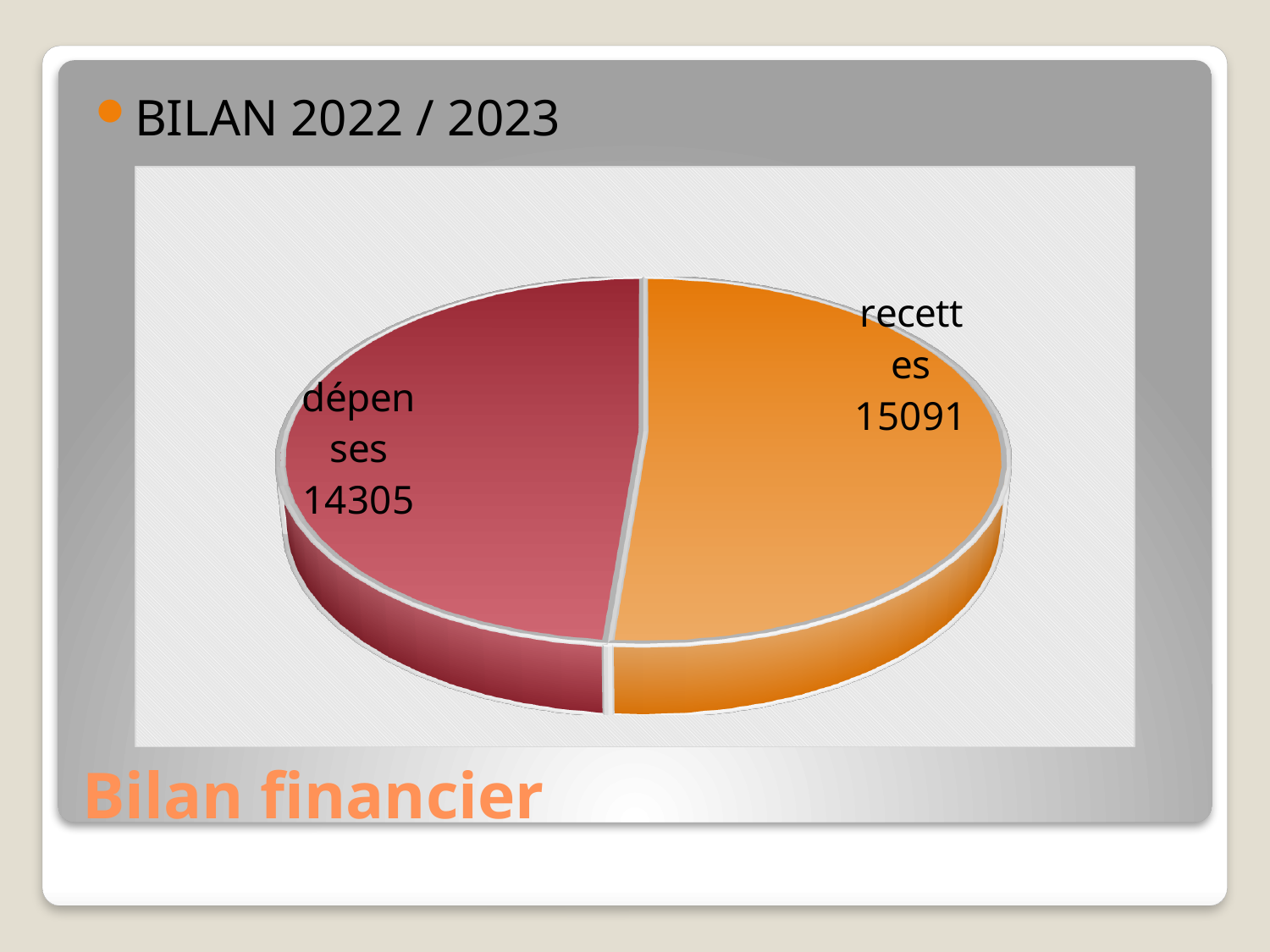
What colour is the recettes slice of the pie chart? orange How many slices does the pie chart have? 2 What is the difference between recettes and dépenses? 786 What share of the pie, to one decimal place, does recettes represent? 51.3% What is the value for dépenses in the pie chart? 14305 Which slice of the pie chart is the smallest? dépenses What is the total of the two values shown in the pie chart? 29396 What is the value for recettes in the pie chart? 15091 What kind of chart is shown on the slide? pie chart Which is larger, dépenses or recettes? recettes What is the heading written above the pie chart? BILAN 2022 / 2023 Which slice of the pie chart is the largest? recettes